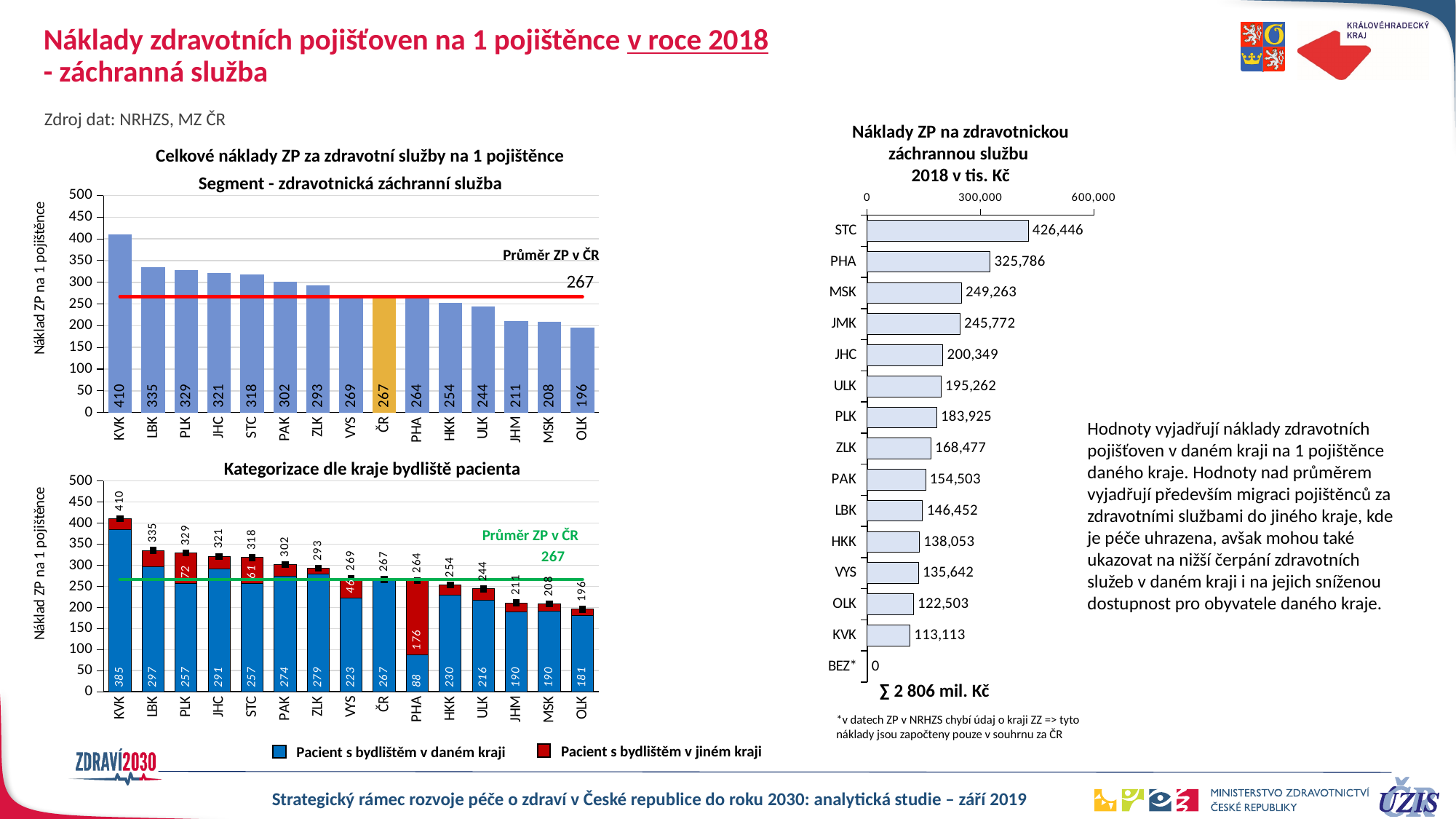
In the right chart 'Náklady ZP na zdravotnickou záchrannou službu 2018 v tis. Kč', what is the value for STC? 426,446 In the right chart 'Náklady ZP na zdravotnickou záchrannou službu 2018 v tis. Kč', which is larger, the value for JHC or the value for ULK? JHC In the bottom-left chart 'Kategorizace dle kraje bydliště pacienta', what is the value of 'Pacient s bydlištěm v daném kraji' for PHA? 88 In the top-left chart 'Celkové náklady ZP za zdravotní služby na 1 pojištěnce', which region has the lowest value? OLK In the right chart 'Náklady ZP na zdravotnickou záchrannou službu 2018 v tis. Kč', what is the difference between the values for STC and PHA? 100,660 In the right chart 'Náklady ZP na zdravotnickou záchrannou službu 2018 v tis. Kč', which region has the highest value? STC In the top-left chart 'Celkové náklady ZP za zdravotní služby na 1 pojištěnce', how many bars are plotted? 15 In the top-left chart 'Celkové náklady ZP za zdravotní služby na 1 pojištěnce', which region has the highest value? KVK In the top-left chart 'Celkové náklady ZP za zdravotní služby na 1 pojištěnce', what is the difference between the values for KVK and OLK? 214 What kind of chart is the top-left chart 'Celkové náklady ZP za zdravotní služby na 1 pojištěnce'? bar chart In the bottom-left chart 'Kategorizace dle kraje bydliště pacienta', how many series does the legend list? 2 In the top-left chart 'Celkové náklady ZP za zdravotní služby na 1 pojištěnce', what is the value for KVK? 410